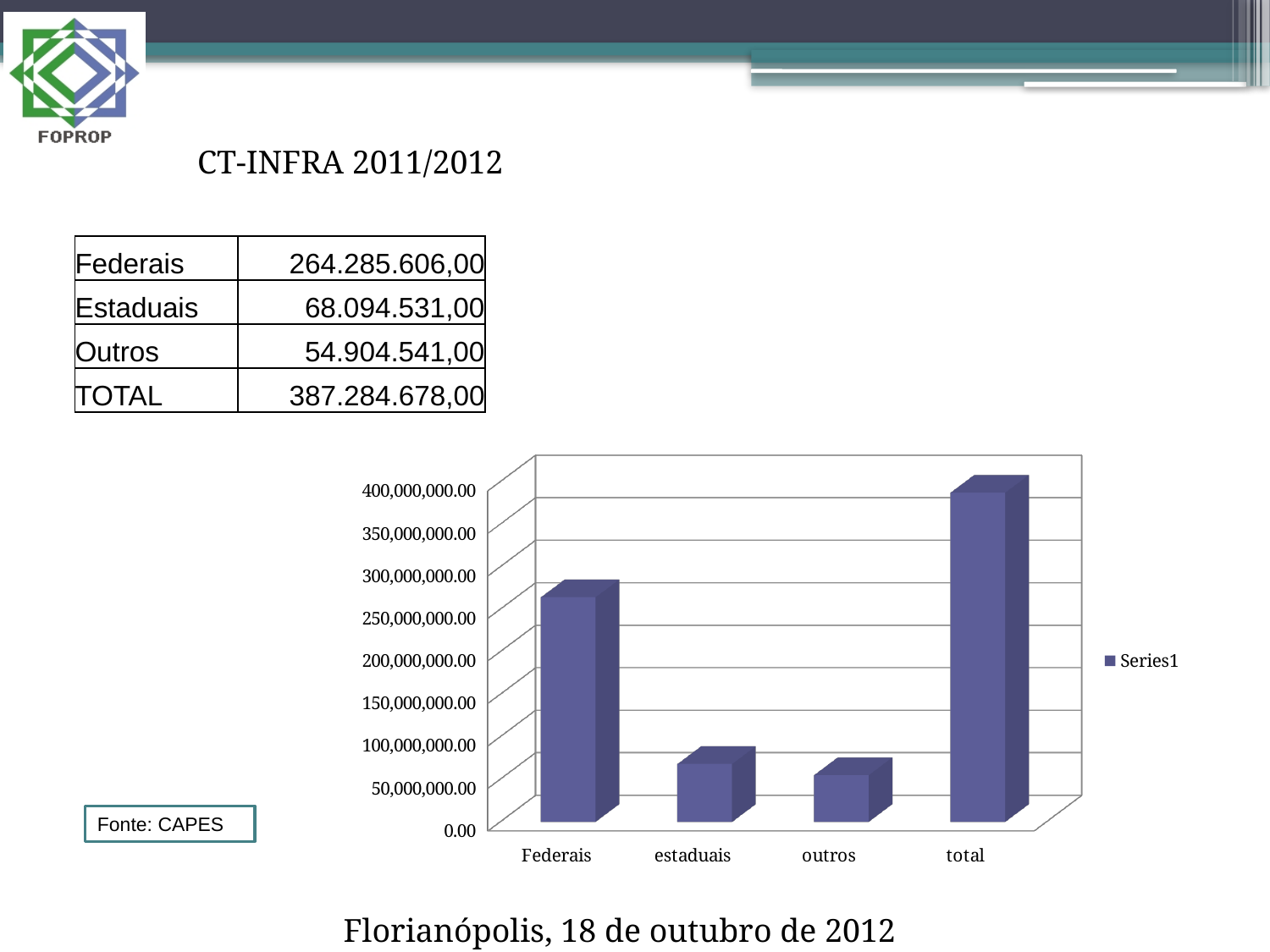
According to the table on the slide, what is the value for TOTAL? 387.284.678,00 Which category has the tallest bar in the chart? total Which bar is taller in the chart, Federais or estaduais? Federais How many categories are shown on the x axis of the chart? 4 Is the value for Federais in the chart greater or less than 250,000,000.00? greater What is the name of the series listed in the chart legend? Series1 What kind of chart is shown on the slide? bar chart Is the value for estaduais in the chart greater or less than 100,000,000.00? less Which category has the shortest bar in the chart? outros How many series does the chart legend list? 1 According to the table on the slide, what is the value for Federais? 264.285.606,00 Is the value for total in the chart greater or less than 350,000,000.00? greater